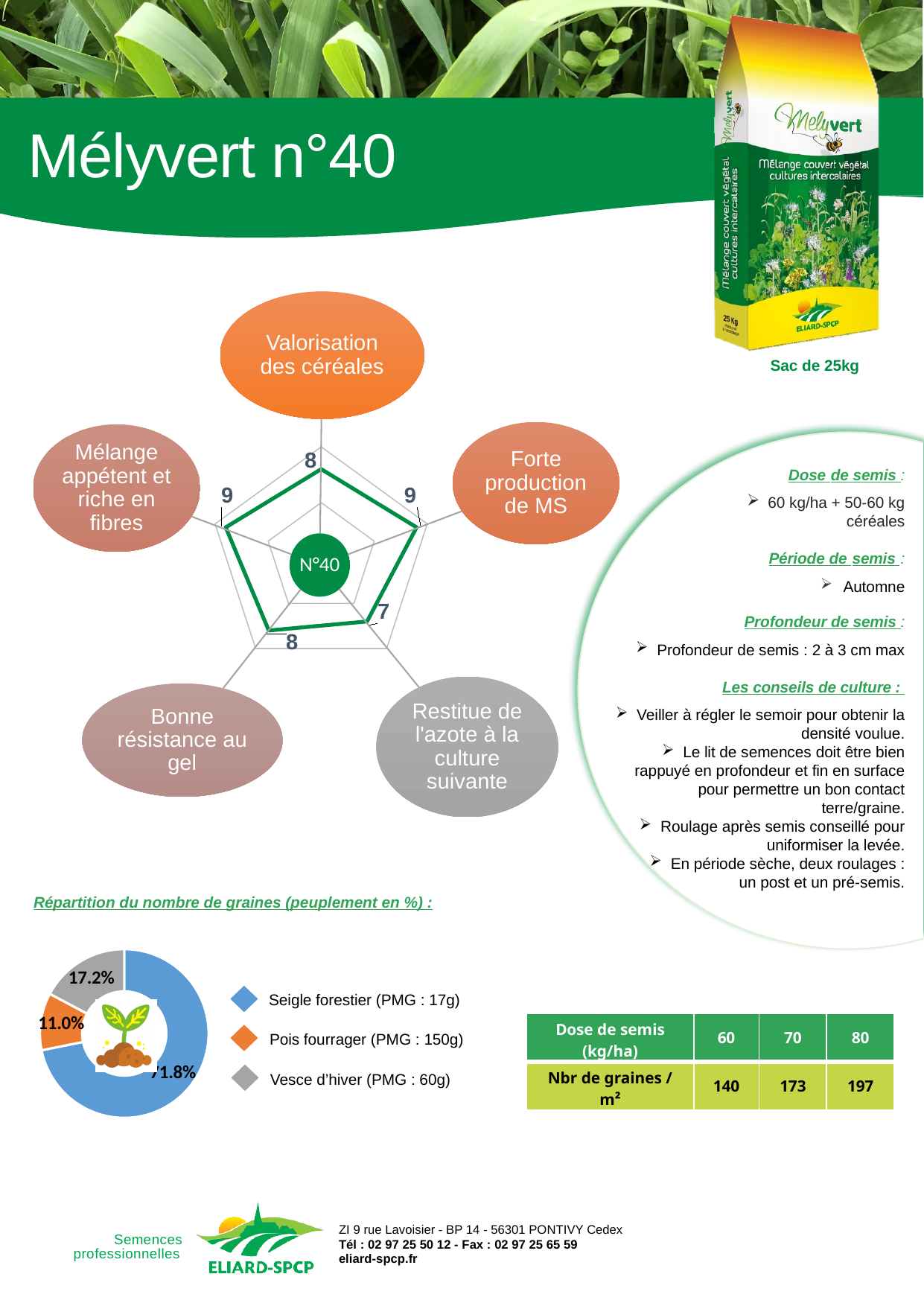
In the doughnut chart, what share does Seigle forestier have? 71.8% In the radar chart, what is the value for Valorisation des céréales? 8 In the radar chart, which criterion has the lowest value? Restitue de l'azote à la culture suivante In the doughnut chart, which species has the smallest share? Pois fourrager In the radar chart, what is the value for Forte production de MS? 9 In the radar chart, what is the difference between the value for Forte production de MS and the value for Restitue de l'azote à la culture suivante? 2 In the radar chart, how many criteria are plotted? 5 In the doughnut chart, what share does Vesce d'hiver have? 17.2% In the doughnut chart, which is larger: the share of Vesce d'hiver or the share of Pois fourrager? Vesce d'hiver In the radar chart, what is the value for Restitue de l'azote à la culture suivante? 7 In the radar chart, what is the value for Bonne résistance au gel? 8 In the doughnut chart, how many species does the legend list? 3